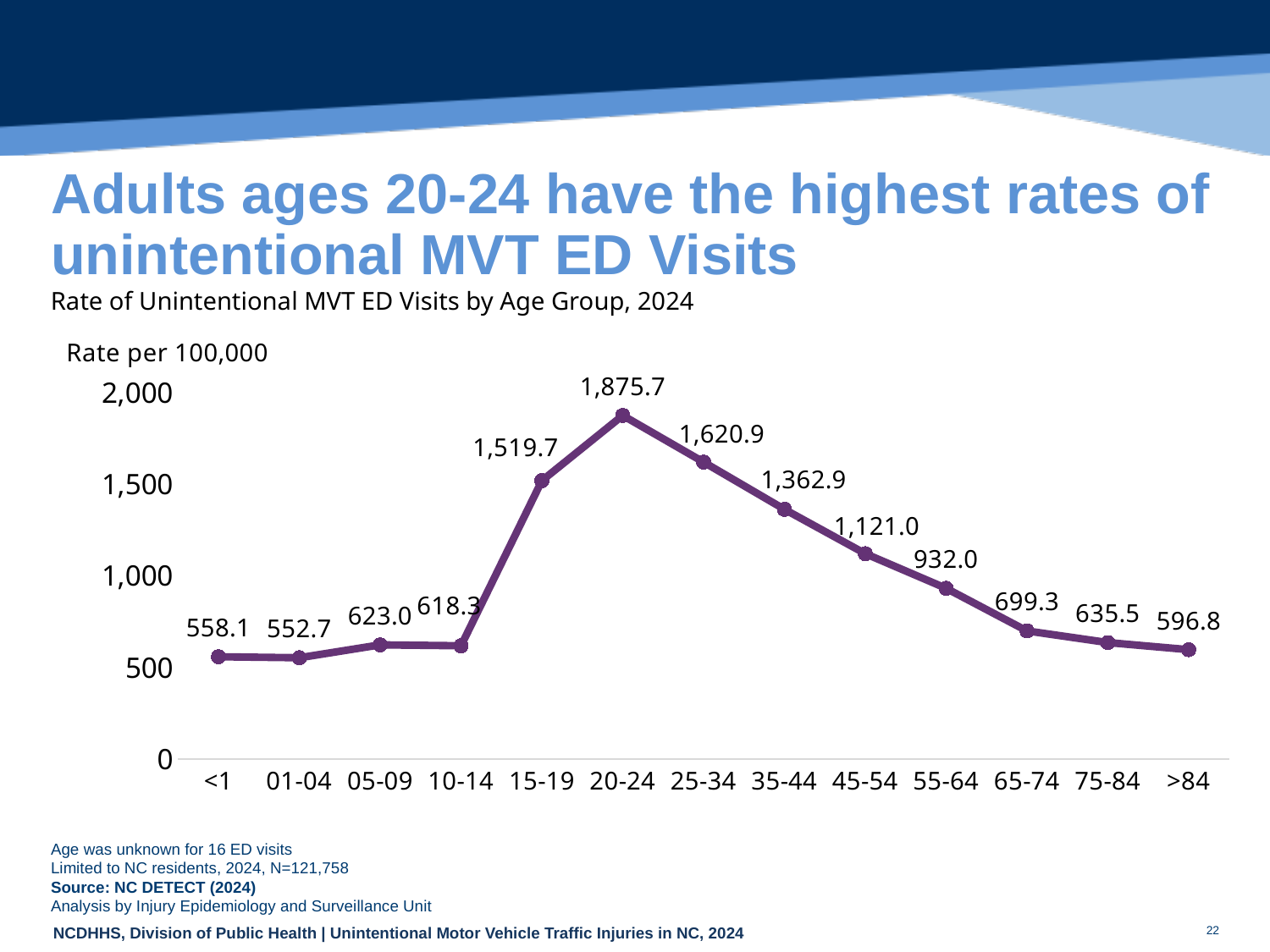
How many age groups are plotted on the chart? 13 What is the difference between the rates for the 20-24 and 25-34 age groups? 254.8 What is the rate per 100,000 for the <1 age group? 558.1 Do the rates rise or fall from the 20-24 age group to the >84 age group? Fall Which age group has a higher rate, 15-19 or 35-44? 15-19 What is the rate per 100,000 of unintentional MVT ED visits for the 20-24 age group? 1,875.7 Is the rate for the 45-54 age group greater or less than 1,000? greater What is the rate per 100,000 for the 55-64 age group? 932.0 What kind of chart is shown on the slide? Line chart Which age group has the highest rate of unintentional MVT ED visits? 20-24 What unit is the y axis of the chart measured in? Rate per 100,000 Which age group has the lowest rate of unintentional MVT ED visits? 01-04